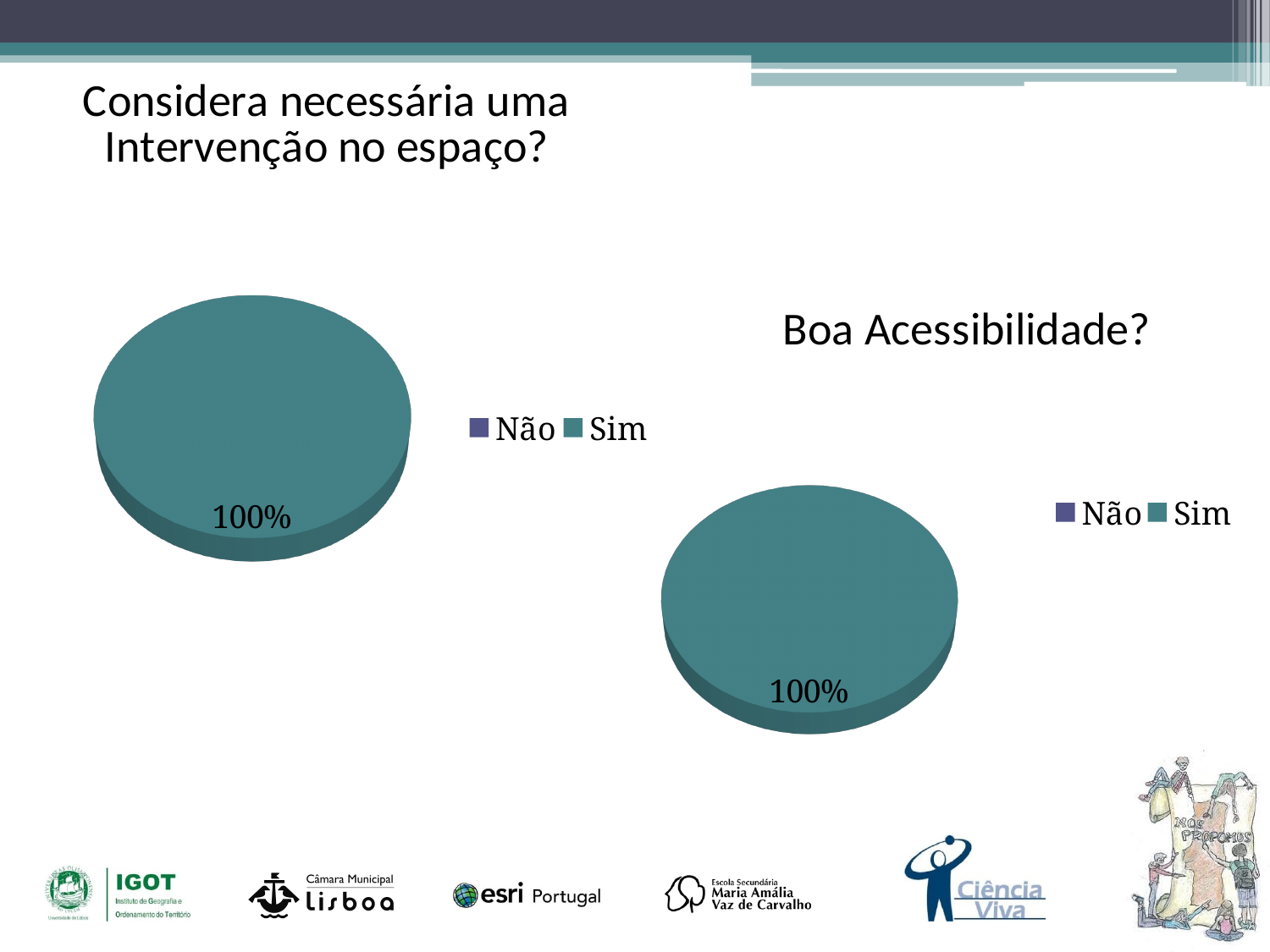
How many entries does the legend of the chart "Considera necessária uma Intervenção no espaço?" list? 2 What are the two legend entries shown for the chart "Boa Acessibilidade?"? Não and Sim In the chart "Considera necessária uma Intervenção no espaço?", what value is printed on the pie? 100% What kind of chart is used for "Boa Acessibilidade?"? Pie chart What kind of chart is used for "Considera necessária uma Intervenção no espaço?"? Pie chart In the chart "Boa Acessibilidade?", what share of the pie does the Sim slice take? 100% In the chart "Boa Acessibilidade?", which category has the largest share? Sim In the chart "Considera necessária uma Intervenção no espaço?", what share of the pie does the Sim slice take? 100% What is the title of the chart on the left side of the slide? Considera necessária uma Intervenção no espaço? In the chart "Boa Acessibilidade?", what value is printed on the pie? 100% How many entries does the legend of the chart "Boa Acessibilidade?" list? 2 In the chart "Considera necessária uma Intervenção no espaço?", which category has the largest share? Sim